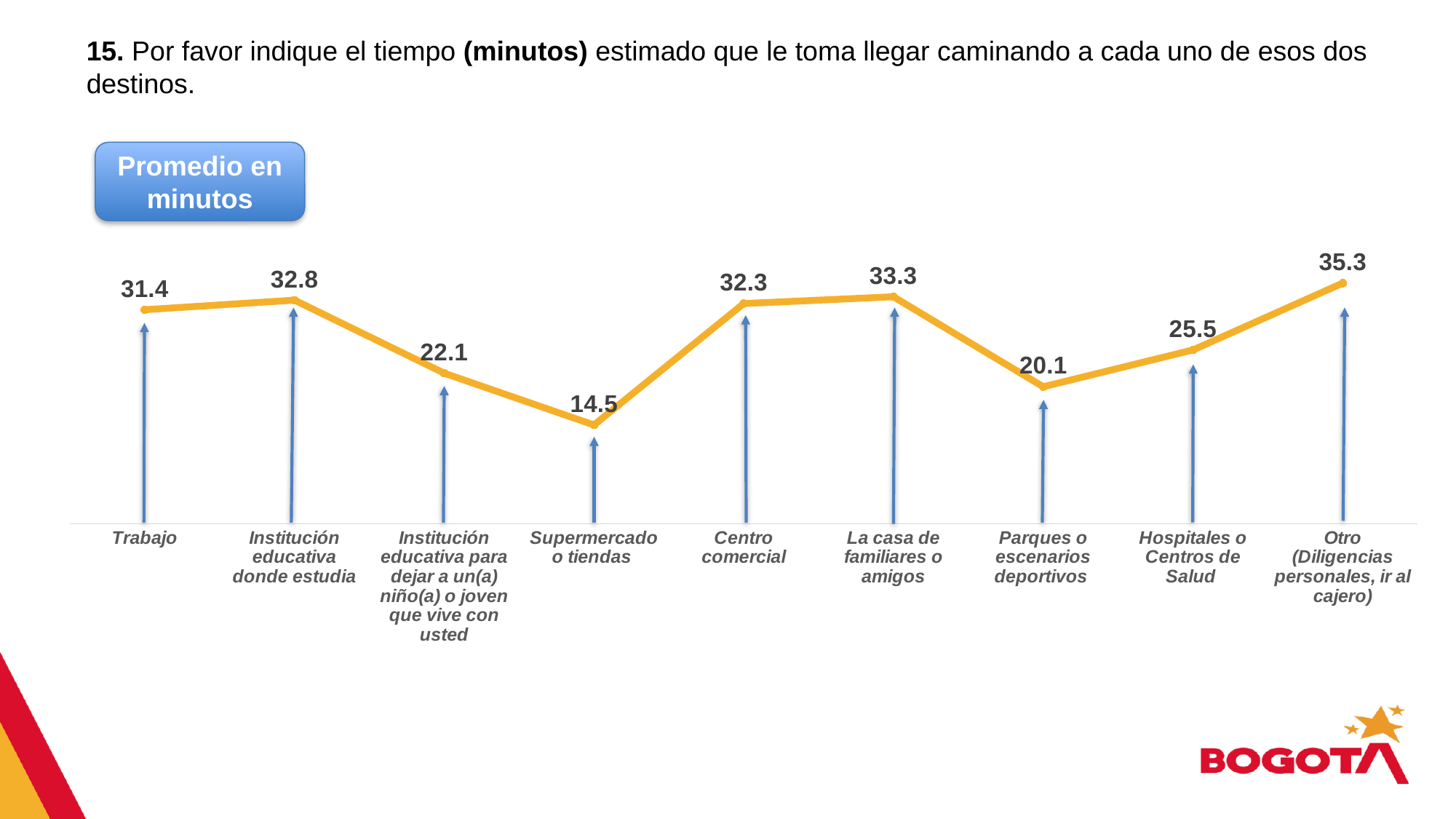
What is the value shown for Supermercado o tiendas? 14.5 Does the value rise or fall from Supermercado o tiendas to Centro comercial? Rise What unit does the blue box say the values are in? Promedio en minutos Which destination has the lowest average time in minutes? Supermercado o tiendas How many destinations are plotted on the chart? 9 What is the difference between the values for Otro (Diligencias personales, ir al cajero) and Trabajo? 3.9 What is the value shown for Hospitales o Centros de Salud? 25.5 What kind of chart is shown on the slide? Line chart What is the difference between the values for La casa de familiares o amigos and Parques o escenarios deportivos? 13.2 What is the average time in minutes to walk to Trabajo? 31.4 Which is larger, the value for Centro comercial or the value for Institución educativa donde estudia? Institución educativa donde estudia Which destination has the highest average time in minutes? Otro (Diligencias personales, ir al cajero)